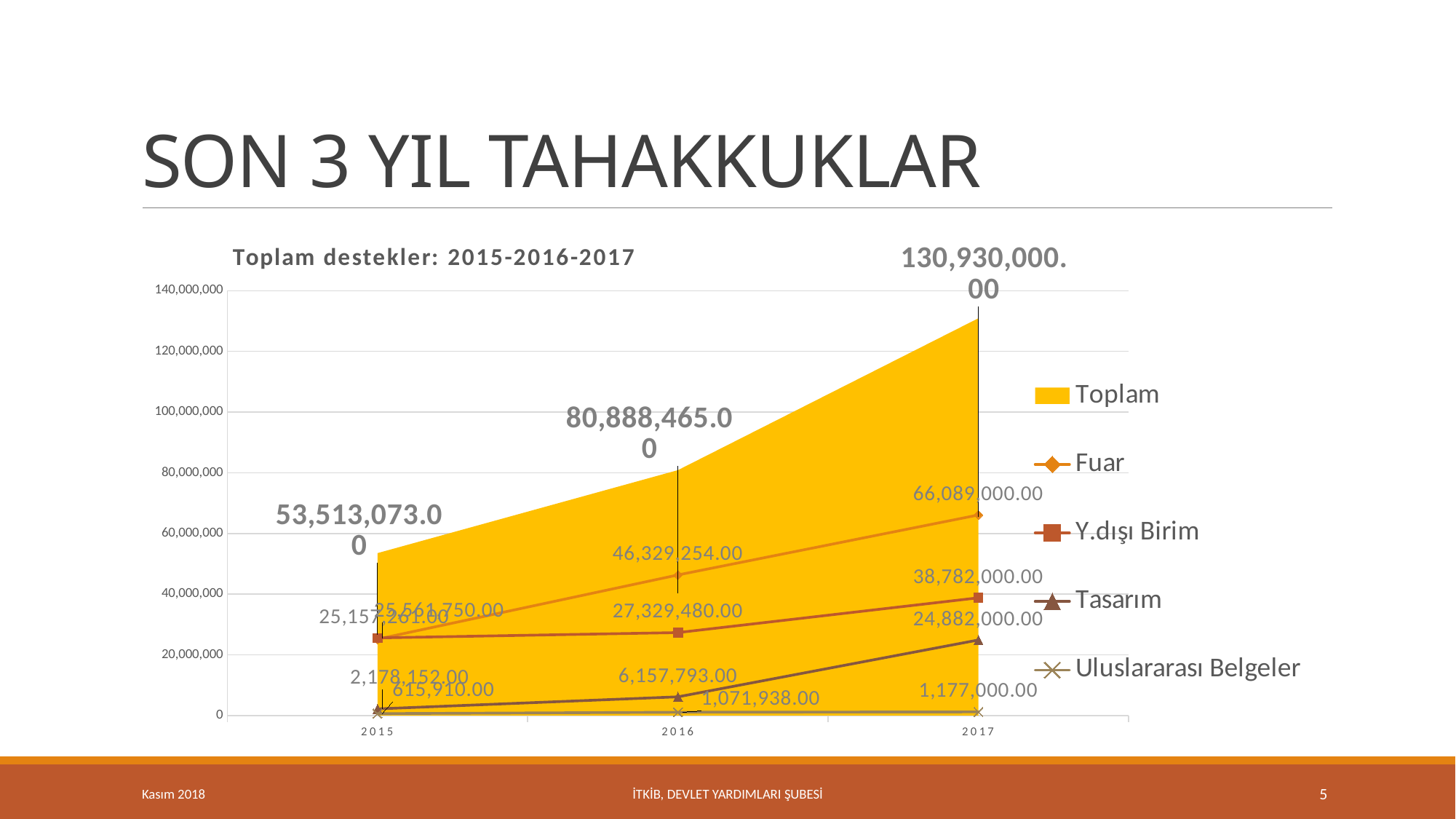
What is the Uluslararası Belgeler value for 2016? 1,071,938.00 What is the Tasarım value for 2017? 24,882,000.00 How many series does the chart legend list? 5 How many years are shown on the x axis of the chart? 3 By how much did the Toplam value increase from 2016 to 2017? 50,041,535.00 Does the Fuar series rise or fall from 2015 to 2017? rise In which year is the Toplam value highest? 2017 What is the title of the chart? Toplam destekler: 2015-2016-2017 What is the Toplam value for 2017? 130,930,000.00 Which series has the lowest value in 2017? Uluslararası Belgeler What is the Fuar value for 2016? 46,329,254.00 What is the Toplam value for 2015? 53,513,073.00